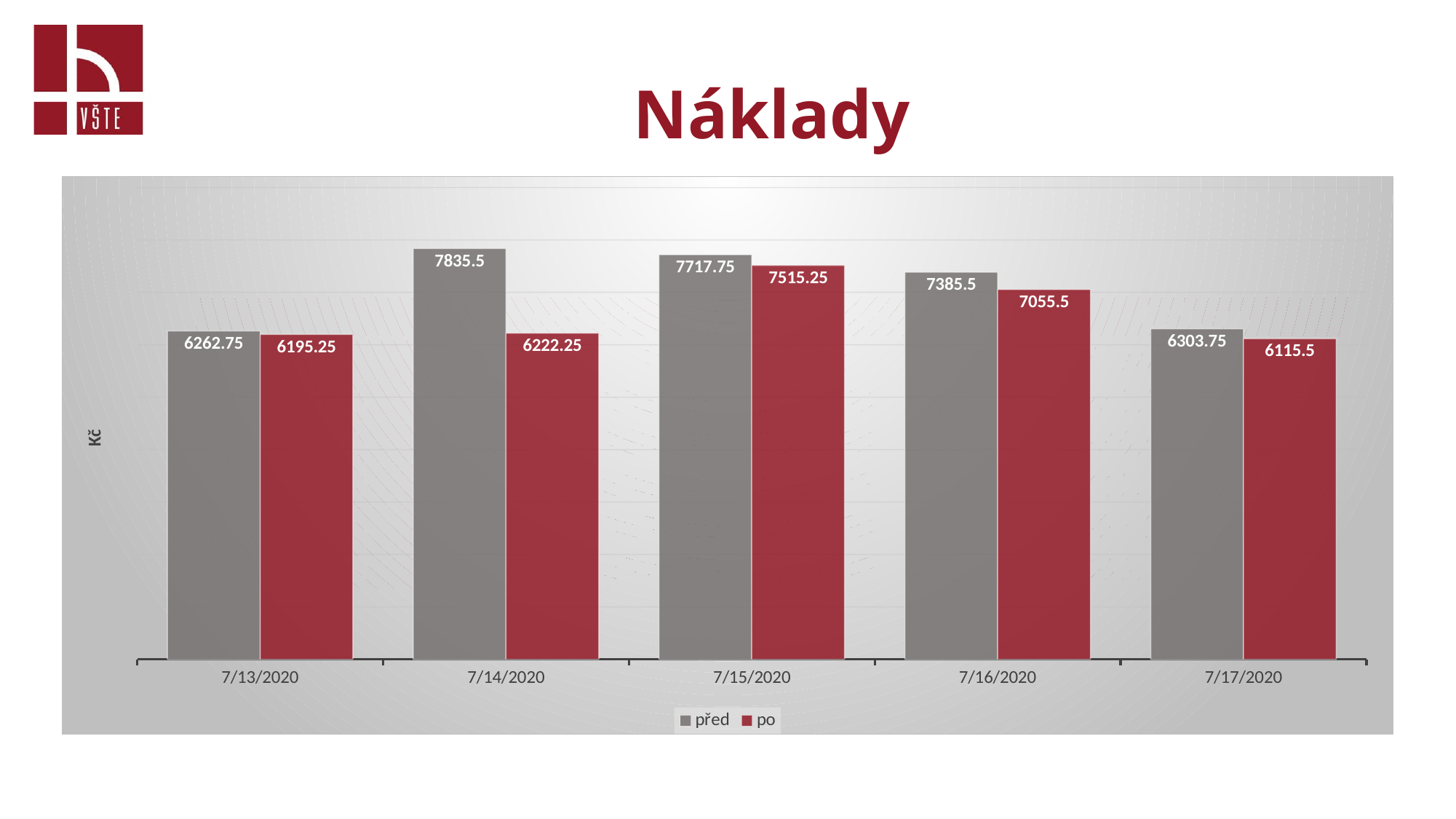
Which date has the highest 'před' value? 7/14/2020 How many series does the legend list? 2 What is the 'po' value for 7/16/2020? 7055.5 What is the difference between the 'před' and 'po' values for 7/14/2020? 1613.25 Which date has the lowest 'po' value? 7/17/2020 What is the label on the vertical axis? Kč What kind of chart is shown on the slide? bar chart What is the 'před' value for 7/14/2020? 7835.5 Which is larger, the 'po' value for 7/15/2020 or the 'po' value for 7/16/2020? 7/15/2020 What is the difference between the 'před' and 'po' values for 7/17/2020? 188.25 How many dates are shown on the x axis? 5 What is the 'po' value for 7/13/2020? 6195.25